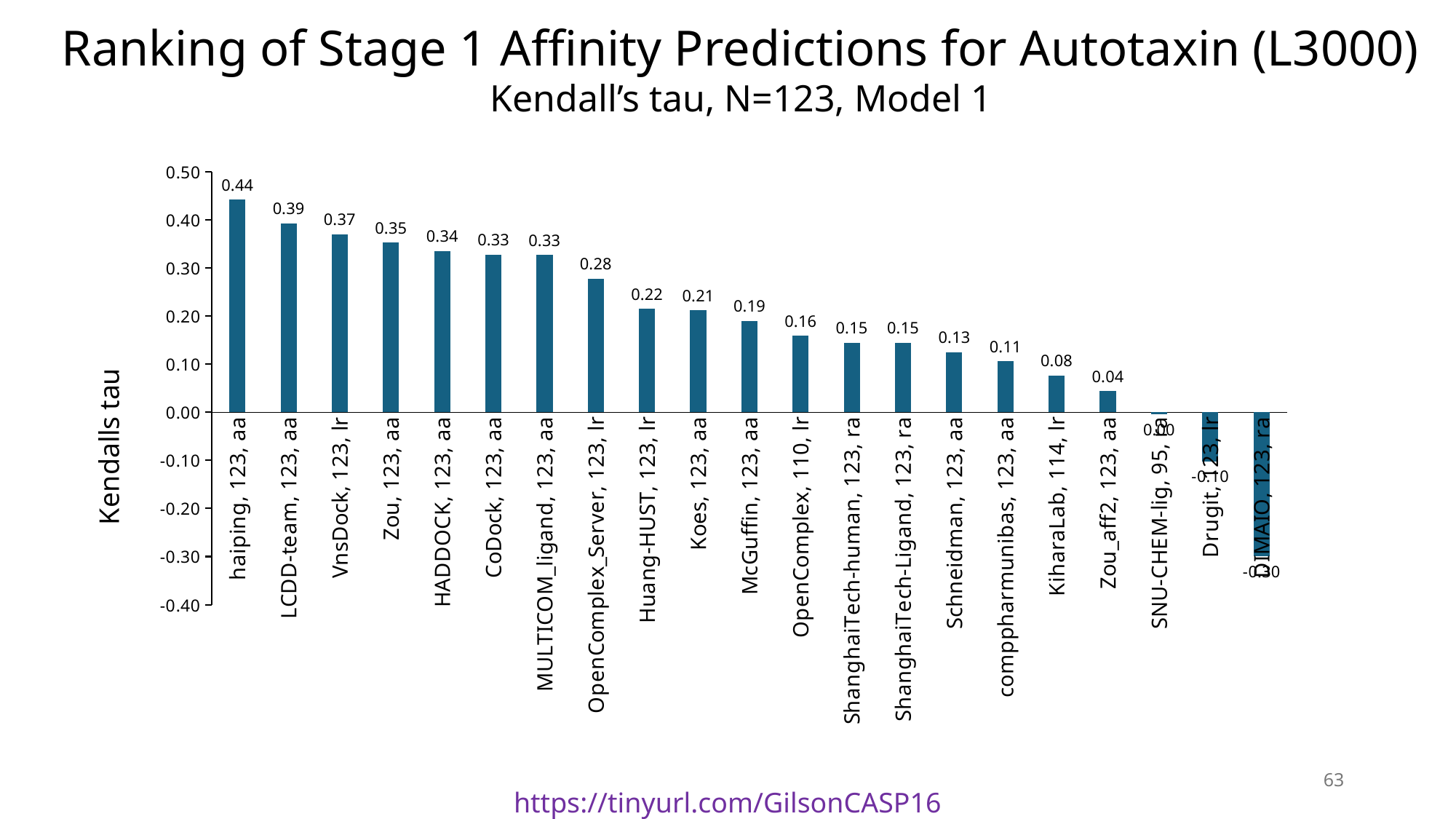
Is the value for Zou, 123, aa greater or less than 0.30? greater What is the difference between the Kendall's tau values for LCDD-team, 123, aa and Koes, 123, aa? 0.18 What is the Kendall's tau value for haiping, 123, aa? 0.44 Do the Kendall's tau values rise or fall from left to right along the x axis? fall What is the Kendall's tau value for KiharaLab, 114, lr? 0.08 What is the Kendall's tau value for OpenComplex_Server, 123, lr? 0.28 What kind of chart is shown on the slide? bar chart Which has a larger Kendall's tau, HADDOCK, 123, aa or McGuffin, 123, aa? HADDOCK, 123, aa Which group has the highest Kendall's tau? haiping, 123, aa How many groups are shown on the x axis? 21 What is the label of the y axis? Kendalls tau Which group has the lowest Kendall's tau? DIMAIO, 123, ra